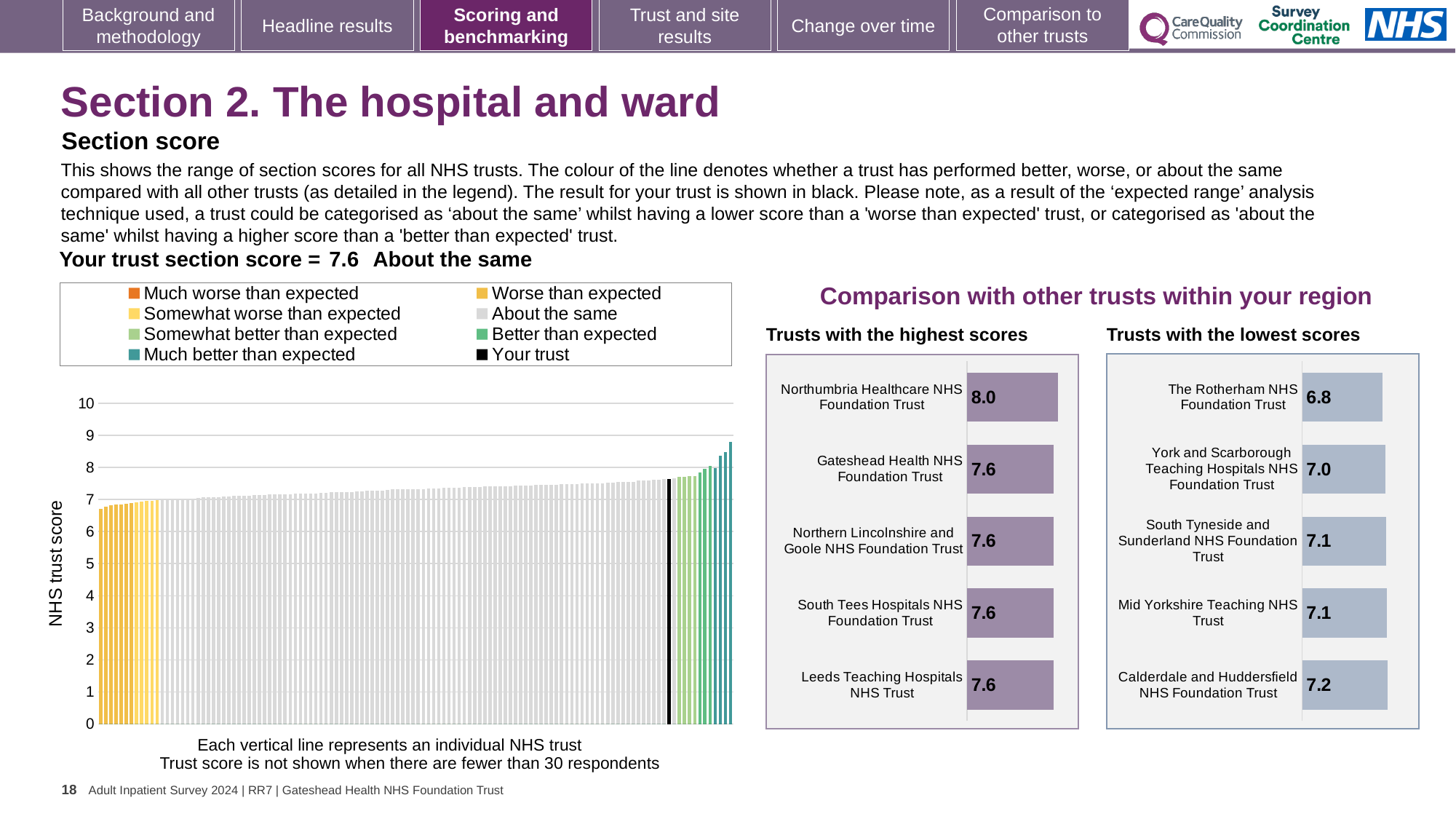
How many entries does the legend of the large NHS trust score chart list? 8 In the 'Trusts with the lowest scores' chart, which has the larger score: York and Scarborough Teaching Hospitals NHS Foundation Trust or Calderdale and Huddersfield NHS Foundation Trust? Calderdale and Huddersfield NHS Foundation Trust In the large NHS trust score chart, is the value of the black bar (your trust) greater or less than 7? greater In the 'Trusts with the lowest scores' chart, what is the score for The Rotherham NHS Foundation Trust? 6.8 What kind of chart is the large chart showing NHS trust scores on the left of the slide? Bar chart In the 'Trusts with the highest scores' chart, what is the score for Northumbria Healthcare NHS Foundation Trust? 8.0 In the 'Trusts with the lowest scores' chart, which trust has the lowest score? The Rotherham NHS Foundation Trust In the large NHS trust score chart, do the values rise or fall from left to right along the x axis? Rise In the 'Trusts with the highest scores' chart, which trust has the highest score? Northumbria Healthcare NHS Foundation Trust What is the difference between the score for Northumbria Healthcare NHS Foundation Trust in the highest scores chart and The Rotherham NHS Foundation Trust in the lowest scores chart? 1.2 How many trusts are shown in the 'Trusts with the highest scores' chart? 5 In the 'Trusts with the lowest scores' chart, what is the score for Calderdale and Huddersfield NHS Foundation Trust? 7.2